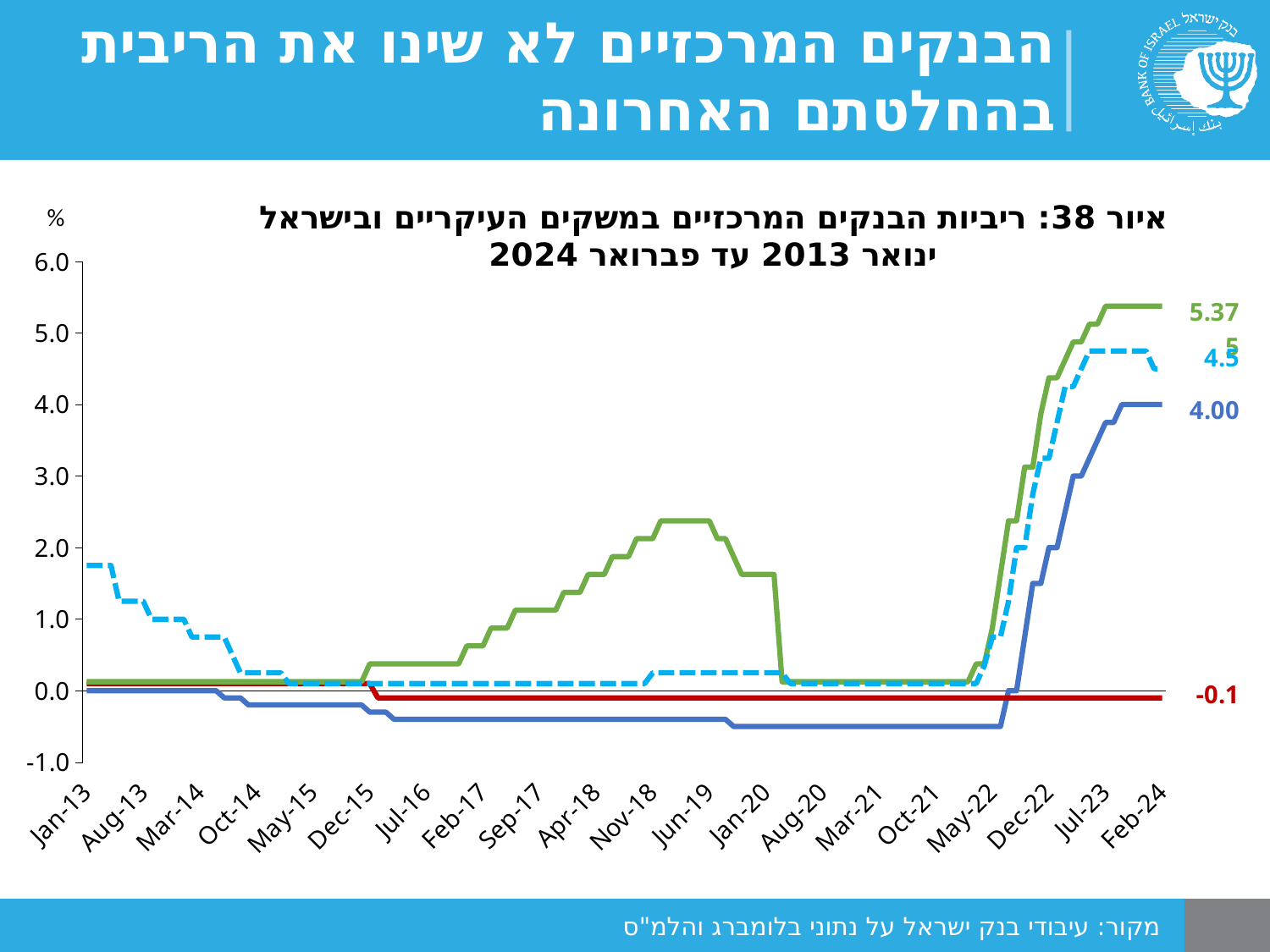
Is the value of the dark blue solid line around Jan-20 greater or less than 0.0? less What is the difference between the end values of the green line (5.37) and the dark blue solid line (4.00)? 1.37 Does the dark blue solid line rise or fall between May-22 and Jul-23? rise Which line ends at the highest value in Feb-24? the green line (5.37) What kind of chart is shown on the slide? line chart What unit is shown on the y axis of the chart? % What is the value labelled at the end of the green line? 5.37 What is the value labelled at the end of the dark blue solid line? 4.00 At the end of the chart, which is larger: the green line's value or the dark blue solid line's value? the green line Is the value of the green line around Jun-19 greater or less than 2.0? greater What is the value labelled at the end of the red line? -0.1 Which line ends at the lowest value in Feb-24? the red line (-0.1)